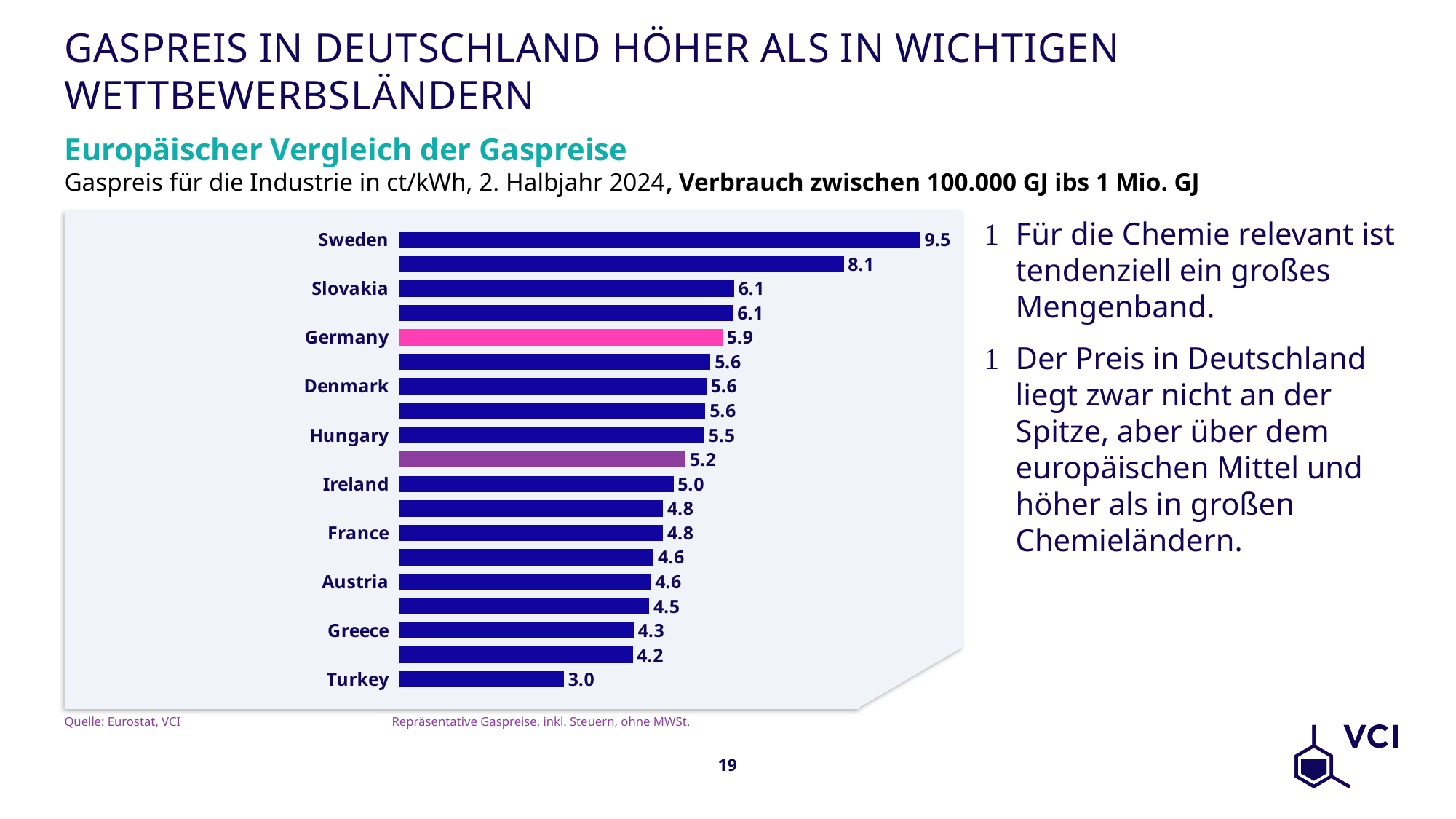
What is the value shown for France? 4.8 Which country's bar is highlighted in pink? Germany Which country has the highest gas price in the chart? Sweden What type of chart is shown on the slide? Bar chart How many bars are plotted in the chart? 19 Which has the higher gas price, Slovakia or Germany? Slovakia What is the gas price shown for Sweden? 9.5 What value is shown for Turkey? 3.0 What is the gas price for Germany in the chart? 5.9 What is the difference between the gas price for Sweden and for Germany? 3.6 What is the difference between the values for Germany and France? 1.1 Which country has the lowest gas price in the chart? Turkey